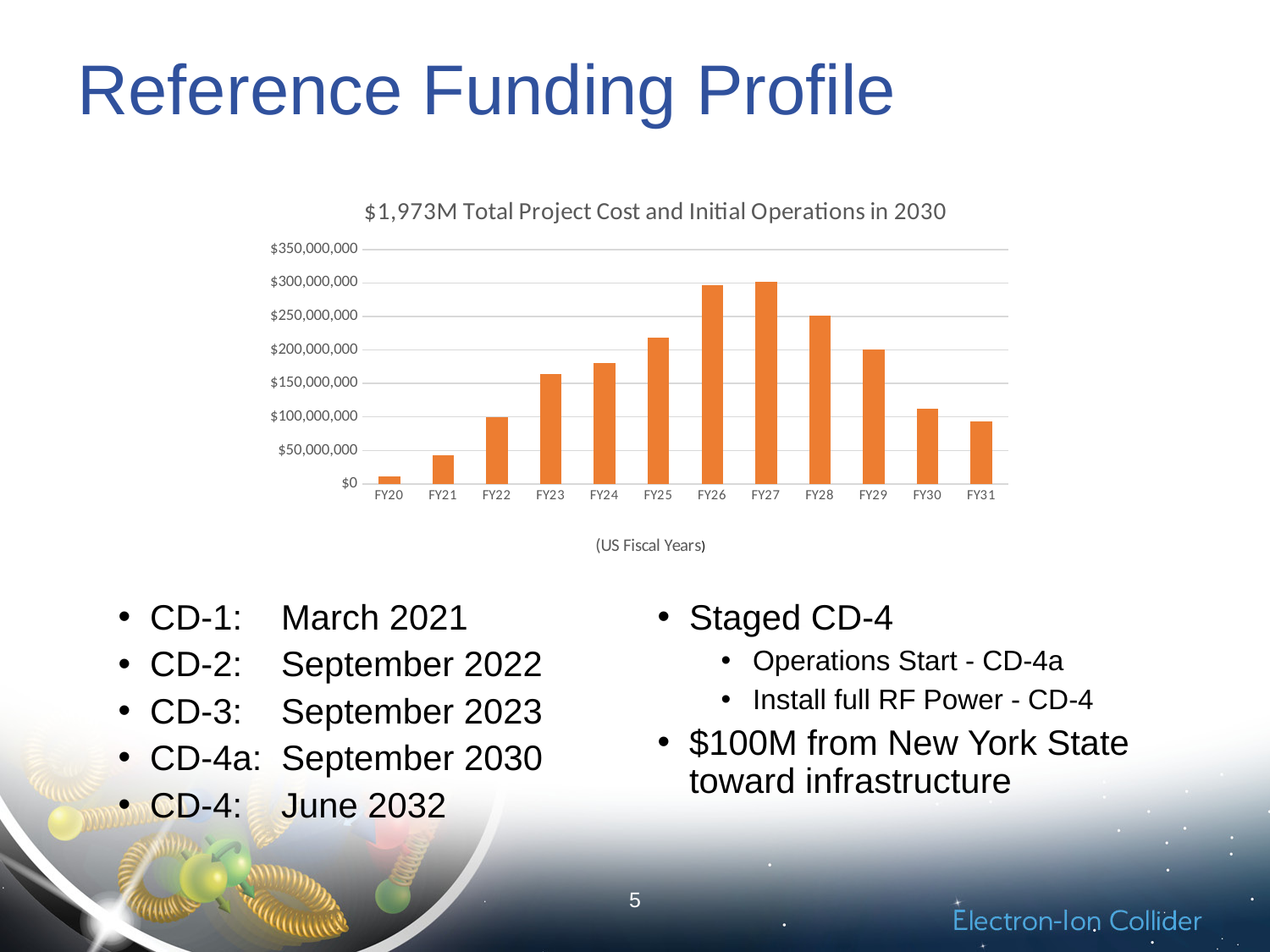
How do the values change from FY27 to FY31? They fall Is the value for FY21 greater or less than $50,000,000? less Which is larger, the value for FY23 or the value for FY30? FY23 Is the value for FY26 greater or less than $250,000,000? greater What kind of chart is shown on the slide? Bar chart Is the value for FY23 greater or less than $150,000,000? greater Which fiscal year has the lowest funding value? FY20 How many fiscal years are plotted on the chart? 12 Which is larger, the value for FY25 or the value for FY28? FY28 What is the title of the chart? $1,973M Total Project Cost and Initial Operations in 2030